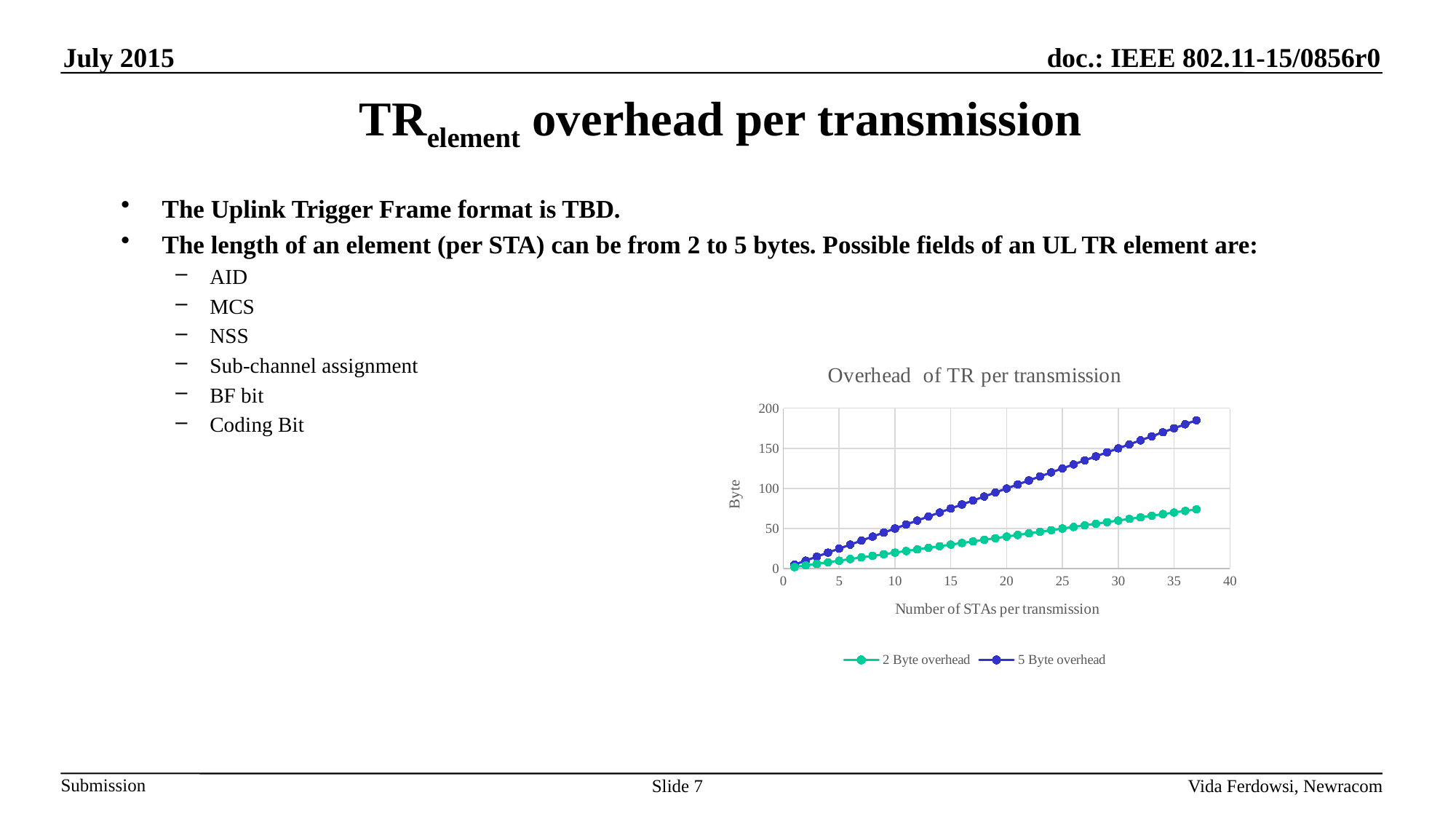
How many series does the chart legend list? 2 What is the label of the x axis of the chart? Number of STAs per transmission What kind of chart is shown on the slide? line chart Is the value for 5 Byte overhead at 25 STAs per transmission greater or less than 100? greater Is the value for 2 Byte overhead at 35 STAs per transmission greater or less than 50? greater What is the title of the chart? Overhead of TR per transmission At 20 STAs per transmission, which series has the larger value, 2 Byte overhead or 5 Byte overhead? 5 Byte overhead Does the 5 Byte overhead series rise or fall as the number of STAs per transmission increases? rise Does the 2 Byte overhead series rise or fall as the number of STAs per transmission increases? rise Which series reaches the highest value on the chart? 5 Byte overhead Is the value for 5 Byte overhead at 35 STAs per transmission greater or less than 150? greater